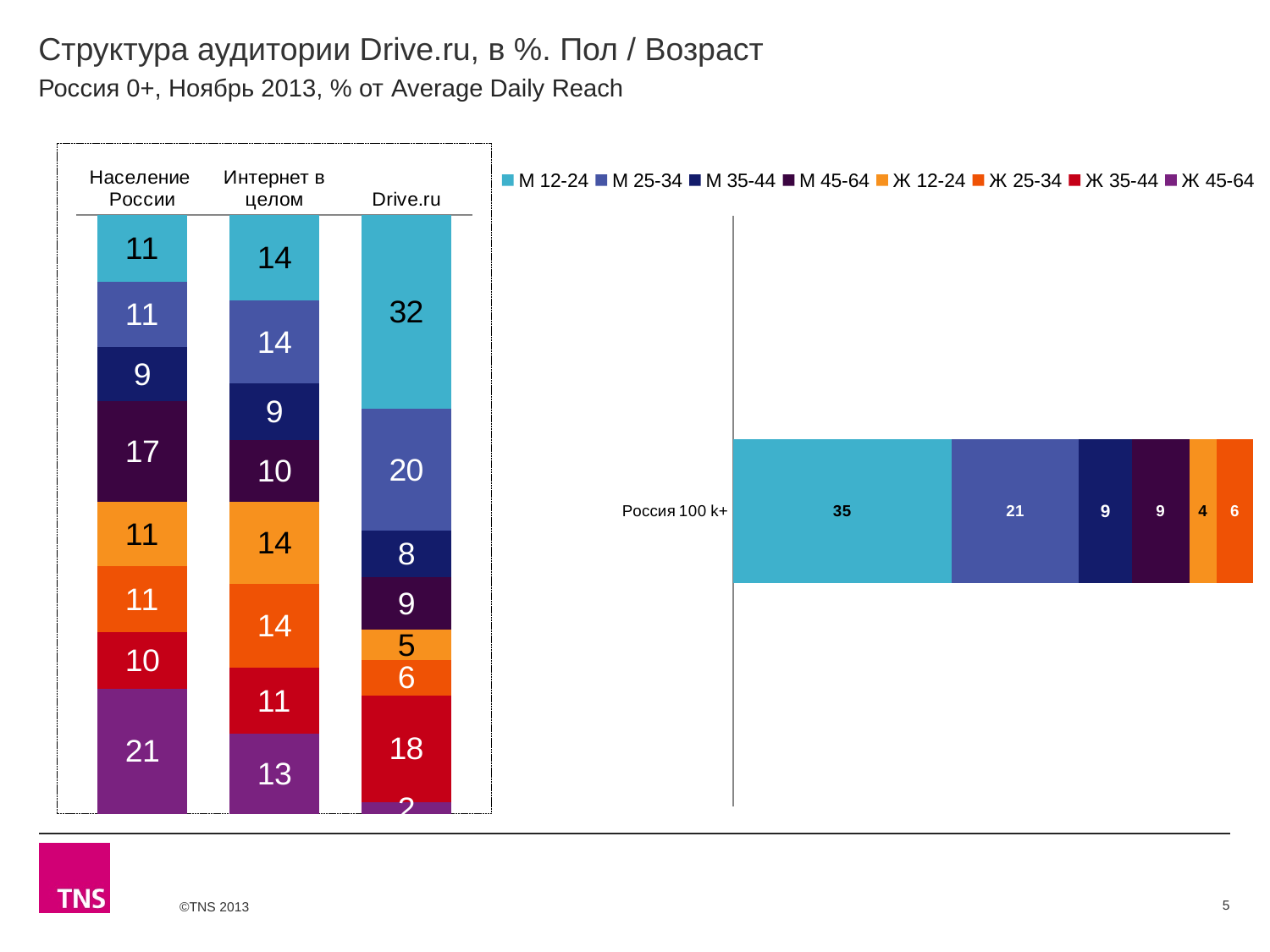
What kind of chart is the right chart? Stacked bar chart In the right chart, what is the value for Ж 12-24 for Россия 100 k+? 4 In the right chart, what is the value for М 12-24 for Россия 100 k+? 35 How many series does the legend list? 8 In the right chart, what is the value for М 25-34 for Россия 100 k+? 21 In the left chart, what is the difference between the М 12-24 value for Drive.ru and the М 12-24 value for Население России? 21 In the left chart, what is the value for М 12-24 in the Drive.ru column? 32 How many columns (categories) are shown in the left chart? 3 In the left chart, which segment is the largest in the Drive.ru column? М 12-24 In the left chart, what is the value for М 35-44 in the Интернет в целом column? 9 In the left chart, which column has the larger Ж 35-44 value, Drive.ru or Интернет в целом? Drive.ru In the left chart, what is the value for Ж 45-64 in the Население России column? 21